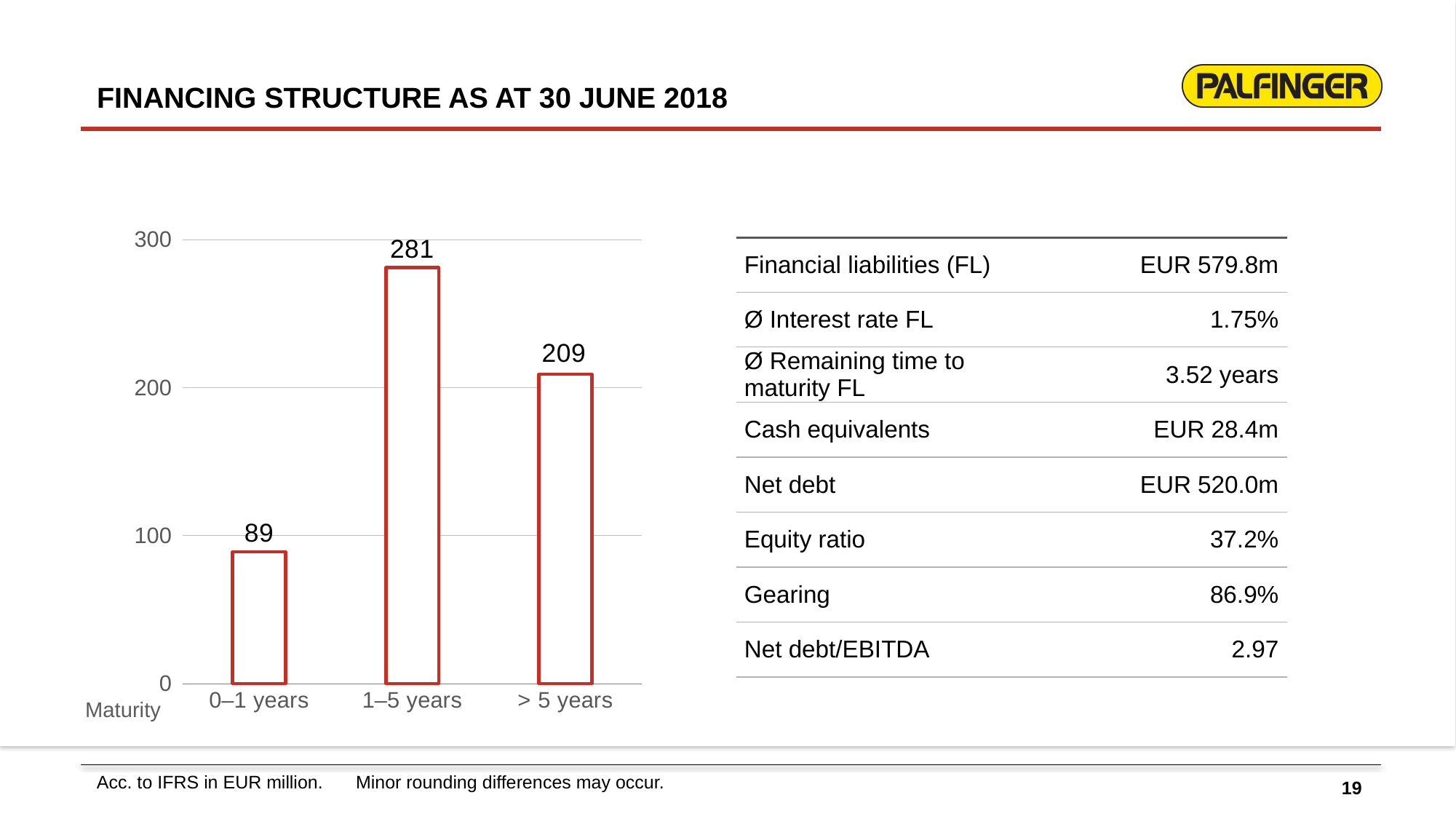
What is the value for the 0–1 years maturity bucket? 89 What kind of chart is shown on the slide? bar chart Which is larger, the value for 0–1 years or the value for > 5 years? > 5 years What is the difference between the 1–5 years and > 5 years values? 72 What is the total of the three maturity bucket values? 579 What is the value for the > 5 years maturity bucket? 209 Which maturity bucket has the highest value? 1–5 years How many maturity buckets are shown in the chart? 3 What is the value for the 1–5 years maturity bucket? 281 Which maturity bucket has the lowest value? 0–1 years Is the value for 0–1 years greater or less than 100? less What is the difference between the > 5 years and 0–1 years values? 120